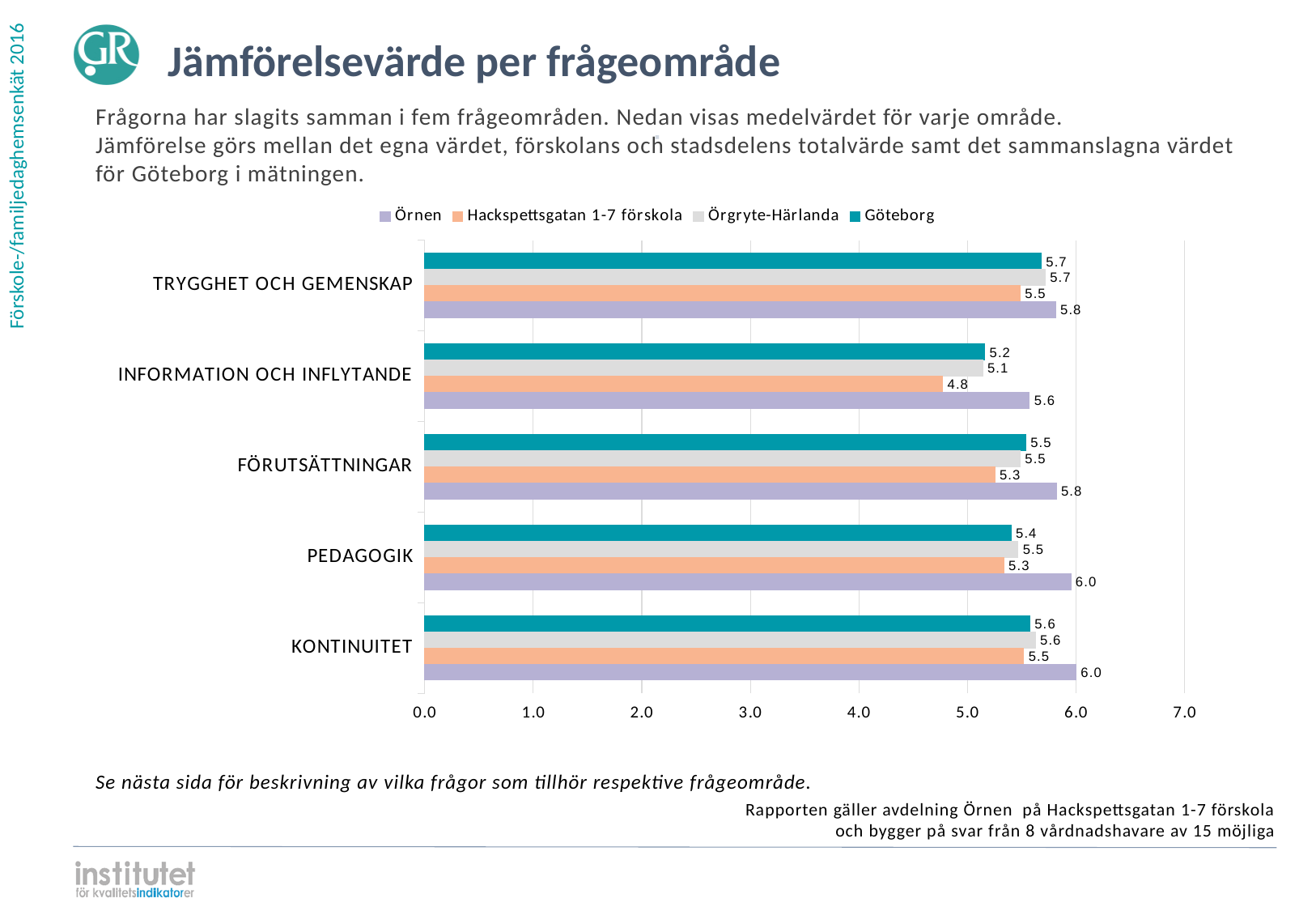
In which category does Hackspettsgatan 1-7 förskola have its lowest value? INFORMATION OCH INFLYTANDE What is the value for Örgryte-Härlanda in the TRYGGHET OCH GEMENSKAP category? 5.7 What kind of chart is shown on the slide? bar chart What is the value for Örnen in the INFORMATION OCH INFLYTANDE category? 5.6 In the PEDAGOGIK category, which is larger: the value for Örnen or the value for Göteborg? Örnen How many series does the legend list? 4 Is the value for Hackspettsgatan 1-7 förskola in the INFORMATION OCH INFLYTANDE category greater or less than 5.0? less What is the value for Hackspettsgatan 1-7 förskola in the PEDAGOGIK category? 5.3 What is the value for Göteborg in the KONTINUITET category? 5.6 How many categories are shown on the chart? 5 Which series has the highest value in the FÖRUTSÄTTNINGAR category? Örnen What is the difference between the Örnen value and the Hackspettsgatan 1-7 förskola value in the INFORMATION OCH INFLYTANDE category? 0.8